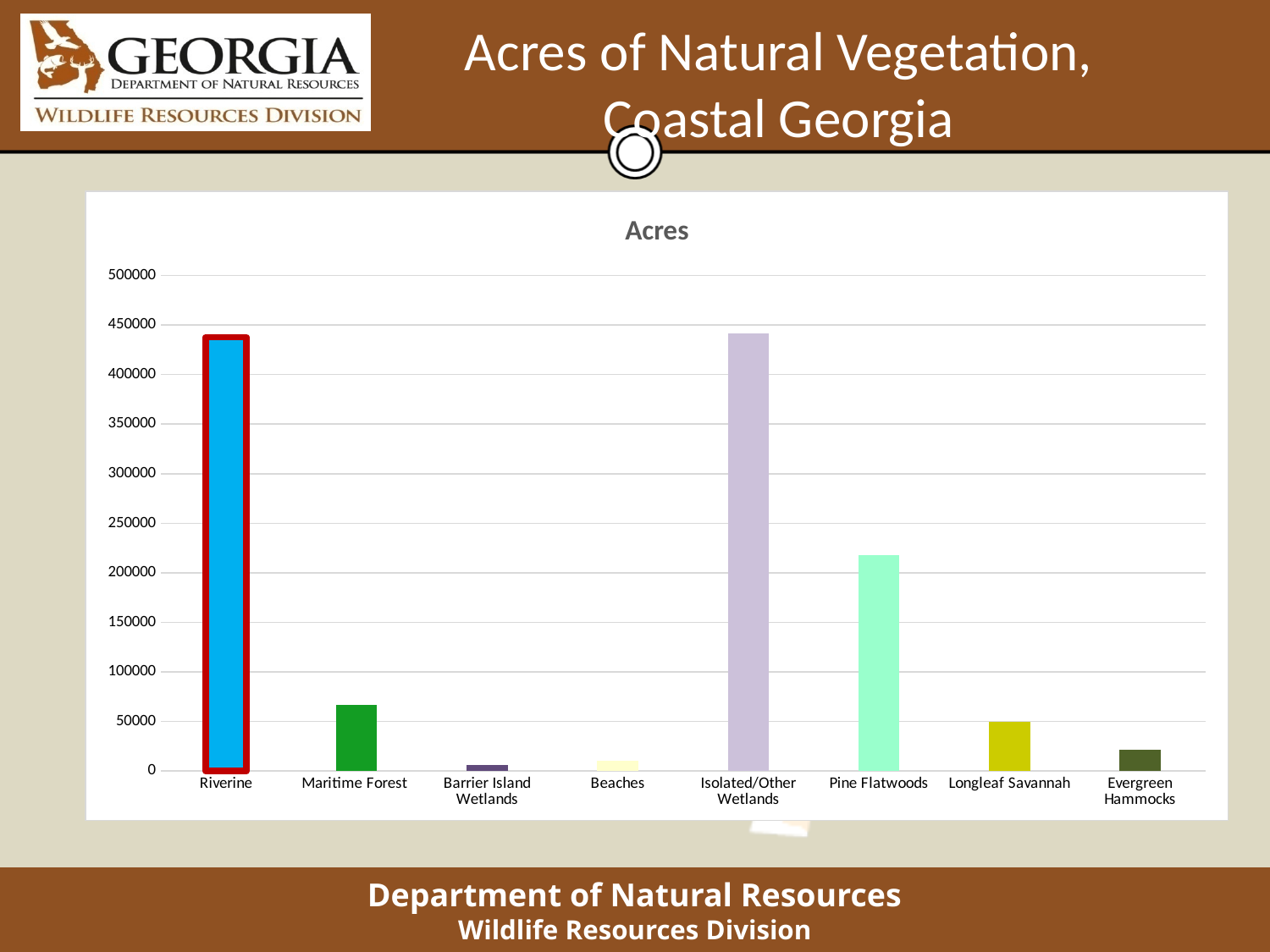
What kind of chart is shown on the slide? bar chart Is the value for Beaches greater or less than 50000? less Which bar on the chart is outlined in red? Riverine Is the value for Pine Flatwoods greater or less than 200000? greater Which has more acres, Pine Flatwoods or Maritime Forest? Pine Flatwoods How many vegetation categories are plotted on the chart? 8 Is the value for Riverine greater or less than 400000? greater What is the title of the chart? Acres Which has more acres, Longleaf Savannah or Evergreen Hammocks? Longleaf Savannah